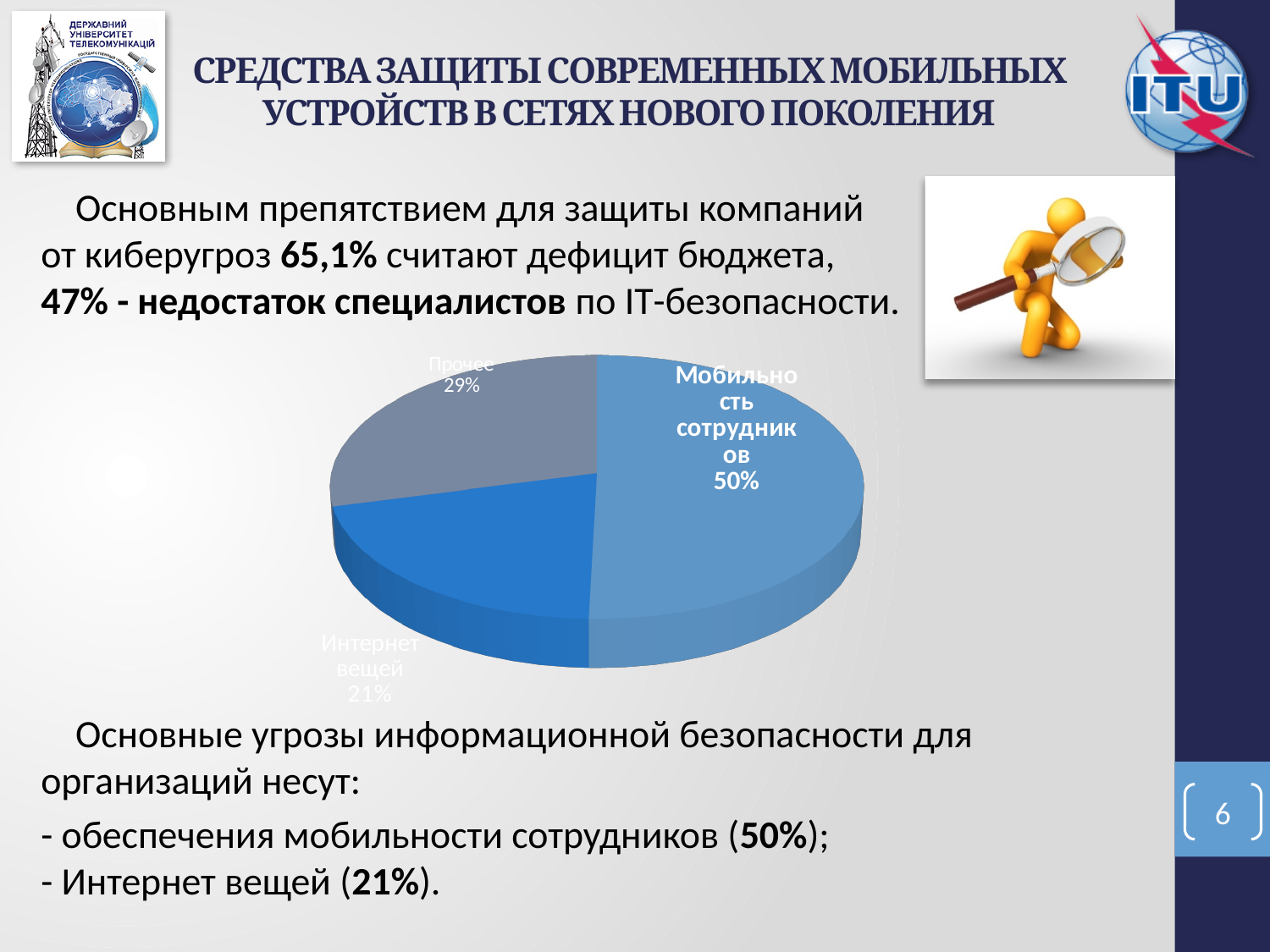
What is the difference in percentage points between "Прочее" and "Интернет вещей"? 8% How many slices does the pie chart have? 3 What kind of chart is shown on the slide? pie chart Which is larger in the pie chart: "Прочее" or "Интернет вещей"? Прочее What share of the pie does "Прочее" have? 29% What share of the pie does "Интернет вещей" have? 21% Is the pie chart drawn in 3D or flat 2D? 3D What is the combined share of "Прочее" and "Интернет вещей" in the pie chart? 50% What is the difference in percentage points between "Мобильность сотрудников" and "Интернет вещей"? 29% Which slice of the pie chart is the smallest? Интернет вещей What share of the pie does "Мобильность сотрудников" have? 50% Which slice of the pie chart is the largest? Мобильность сотрудников